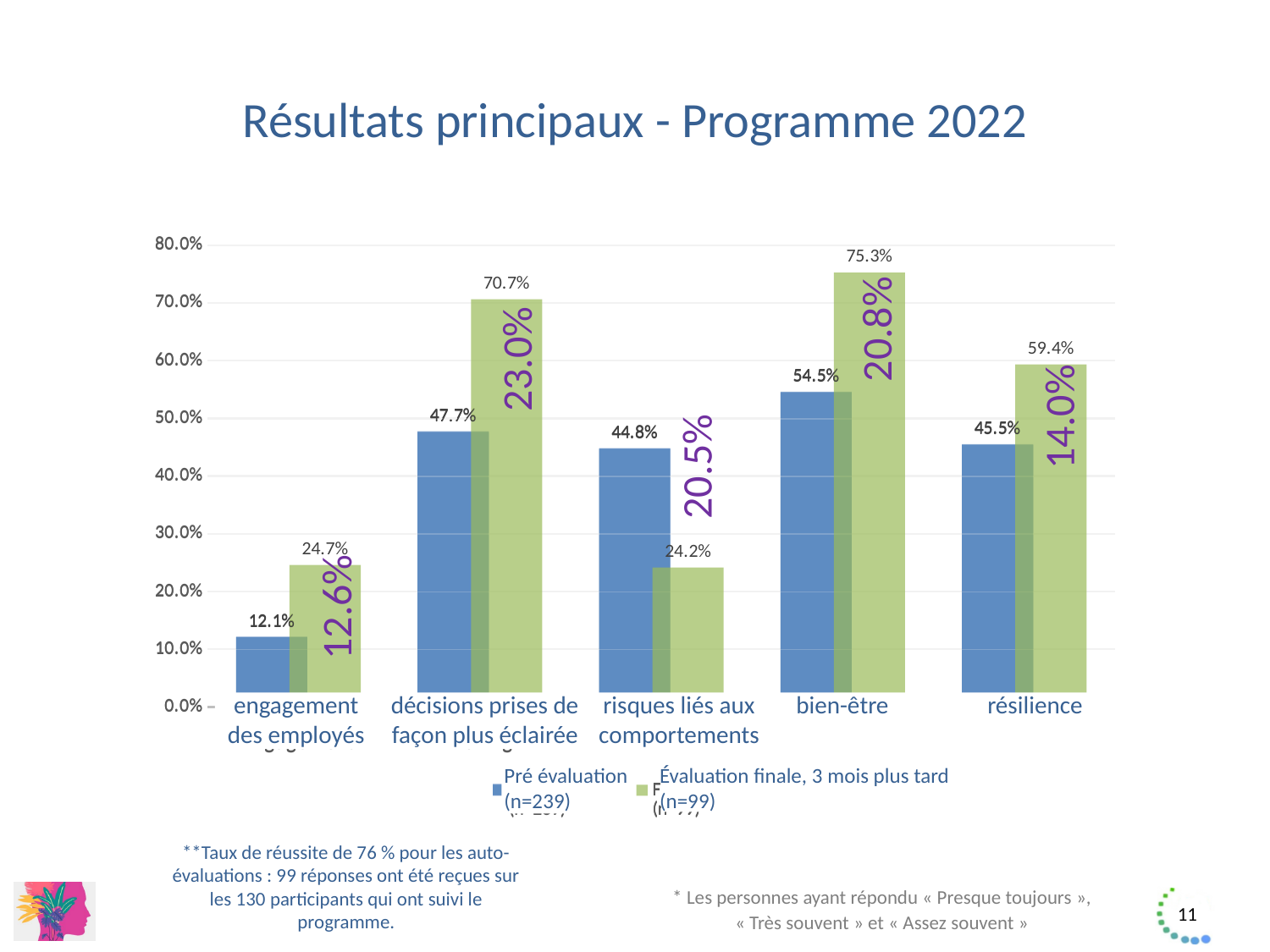
What is the Évaluation finale value for décisions prises de façon plus éclairée? 70.7% What is the title of the slide? Résultats principaux - Programme 2022 What is the Pré évaluation value for bien-être? 54.5% What kind of chart is shown on the slide? bar chart Is the Évaluation finale value for engagement des employés greater or less than 20.0%? greater How many series does the legend list? 2 How many categories are shown on the x axis? 5 For risques liés aux comportements, which is larger: the Pré évaluation value or the Évaluation finale value? Pré évaluation What is the Évaluation finale value for risques liés aux comportements? 24.2% What is the difference between the Évaluation finale and Pré évaluation values for résilience? 13.9% Which category has the highest Évaluation finale value? bien-être Which category has the lowest Pré évaluation value? engagement des employés